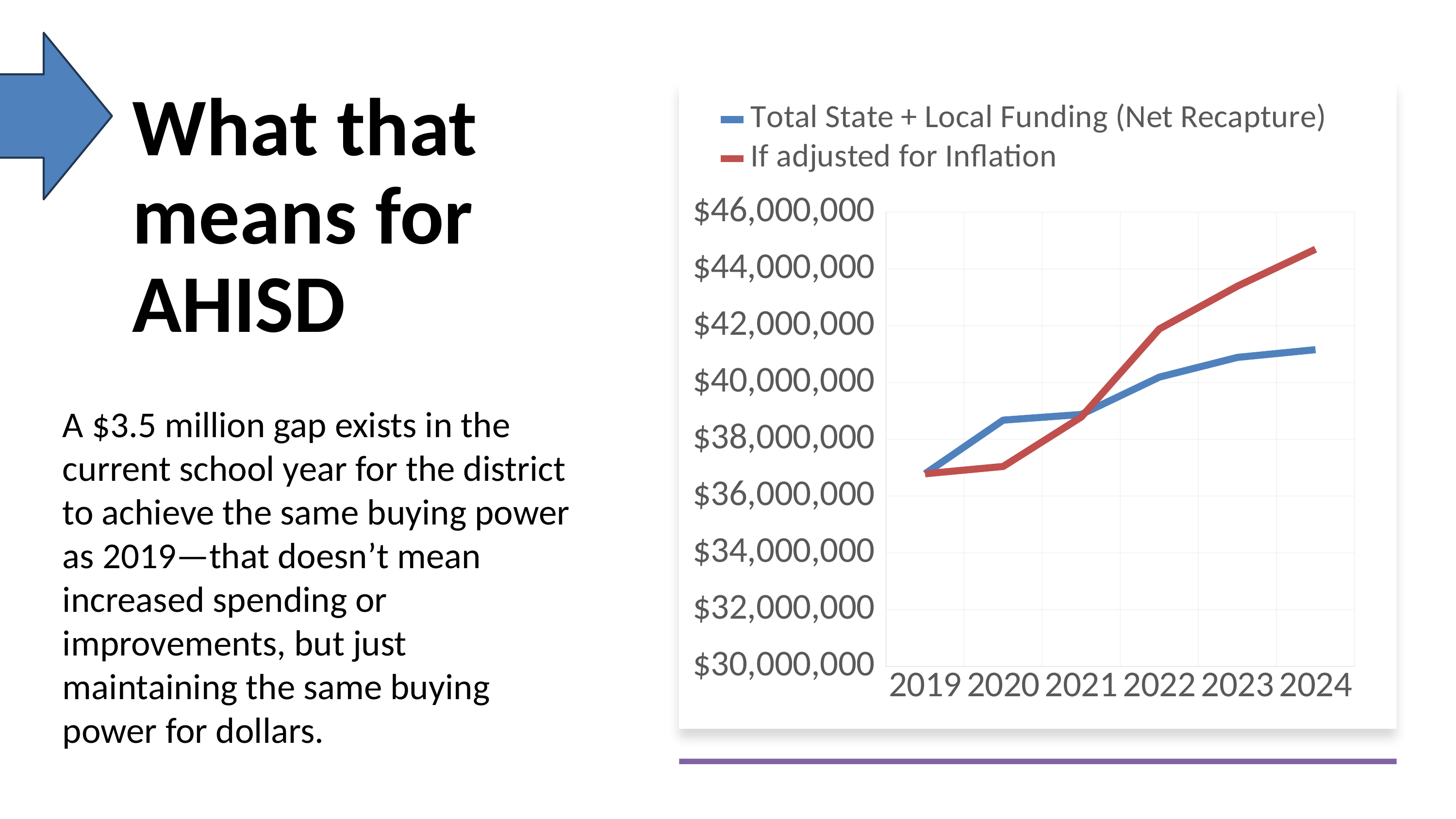
Is the value for 'If adjusted for Inflation' in 2023 greater or less than $42,000,000? greater Is the value for 'If adjusted for Inflation' in 2024 greater or less than $44,000,000? greater In 2024, which series has the larger value: 'Total State + Local Funding (Net Recapture)' or 'If adjusted for Inflation'? If adjusted for Inflation Does the 'If adjusted for Inflation' series rise or fall from 2019 to 2024? rise In which year is the 'Total State + Local Funding (Net Recapture)' series at its lowest value? 2019 What kind of chart is shown on the slide? line chart Is the value for 'Total State + Local Funding (Net Recapture)' in 2024 greater or less than $40,000,000? greater In 2020, which series has the larger value: 'Total State + Local Funding (Net Recapture)' or 'If adjusted for Inflation'? Total State + Local Funding (Net Recapture) In which year does the 'If adjusted for Inflation' series reach its highest value? 2024 How many series does the chart legend list? 2 How many years are shown on the x axis of the chart? 6